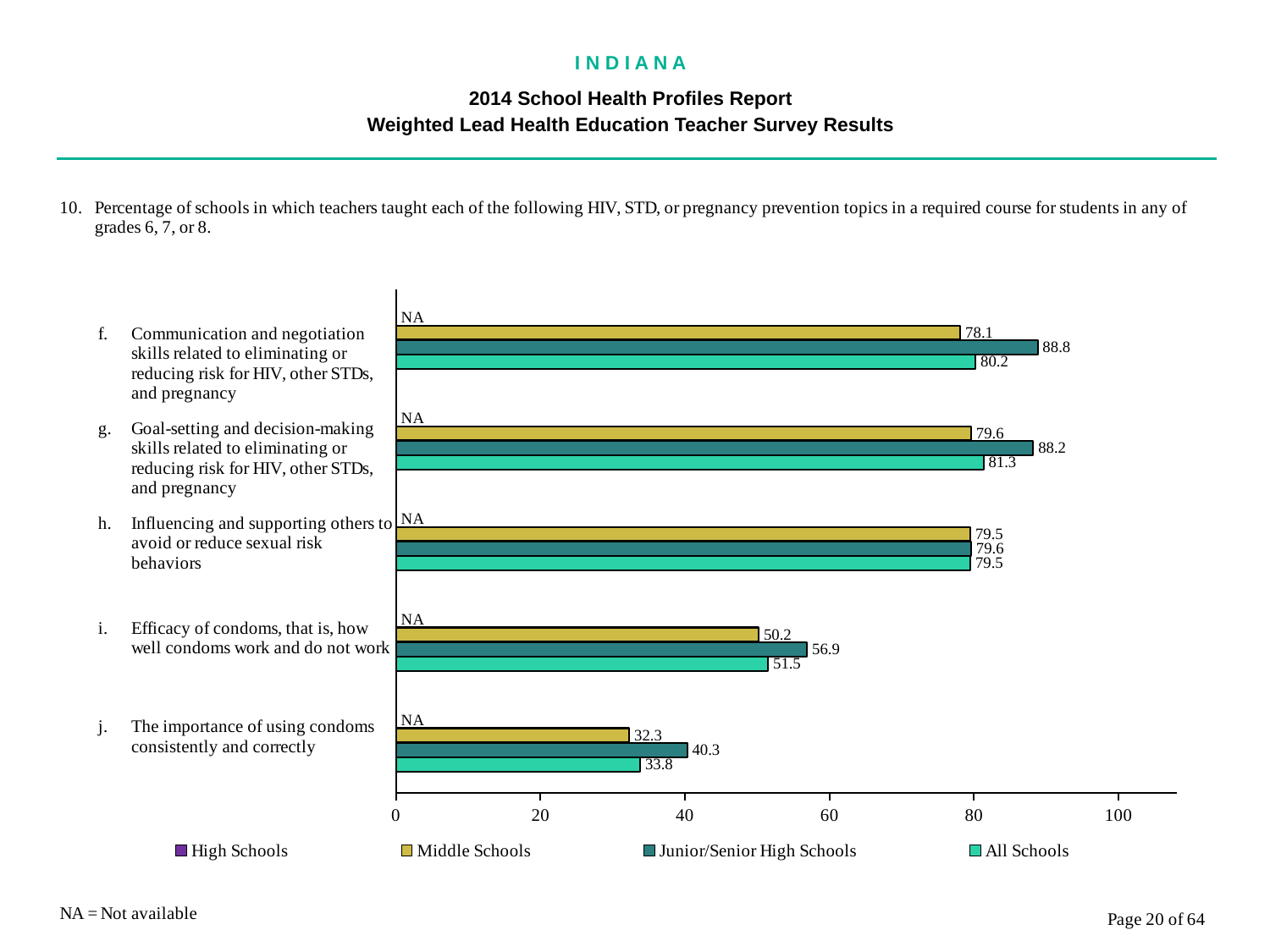
Which topic has the lowest All Schools value? The importance of using condoms consistently and correctly How many series does the legend list? 4 What is the difference between the Junior/Senior High Schools and Middle Schools values for 'The importance of using condoms consistently and correctly'? 8 What kind of chart is shown on the slide? Bar chart What is the All Schools value for 'The importance of using condoms consistently and correctly'? 33.8 What value is shown for High Schools for every topic on the chart? NA What is the Junior/Senior High Schools value for 'Efficacy of condoms, that is, how well condoms work and do not work'? 56.9 How many topics (categories) are shown on the chart? 5 What is the Junior/Senior High Schools value for 'Goal-setting and decision-making skills related to eliminating or reducing risk for HIV, other STDs, and pregnancy'? 88.2 For 'Efficacy of condoms, that is, how well condoms work and do not work', which is larger: the Middle Schools value or the Junior/Senior High Schools value? Junior/Senior High Schools Which topic has the highest Junior/Senior High Schools value? Communication and negotiation skills related to eliminating or reducing risk for HIV, other STDs, and pregnancy What is the Middle Schools value for 'Communication and negotiation skills related to eliminating or reducing risk for HIV, other STDs, and pregnancy'? 78.1